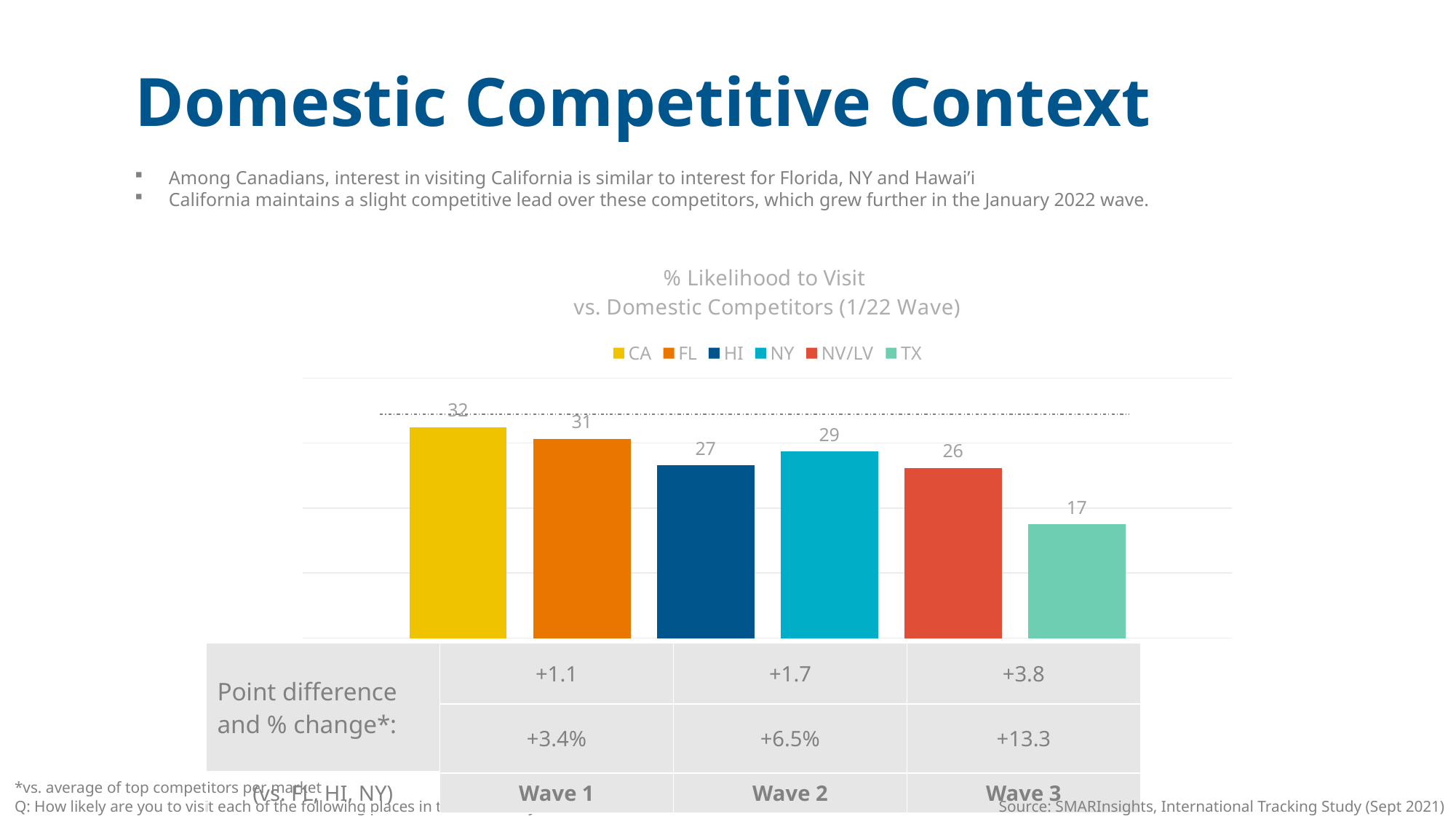
Which has a higher value, NY or NV/LV? NY What is the value shown for NY? 29 What is the difference between the values for CA and TX? 15 What is the difference between the values for FL and HI? 4 How many destinations are plotted in the chart? 6 What is the % likelihood to visit value for TX? 17 Which destination has the highest % likelihood to visit? CA What is the % likelihood to visit value for CA? 32 What is the title of the chart? % Likelihood to Visit vs. Domestic Competitors (1/22 Wave) How many series does the legend list? 6 Which destination has the lowest % likelihood to visit? TX What kind of chart is shown on the slide? Bar chart